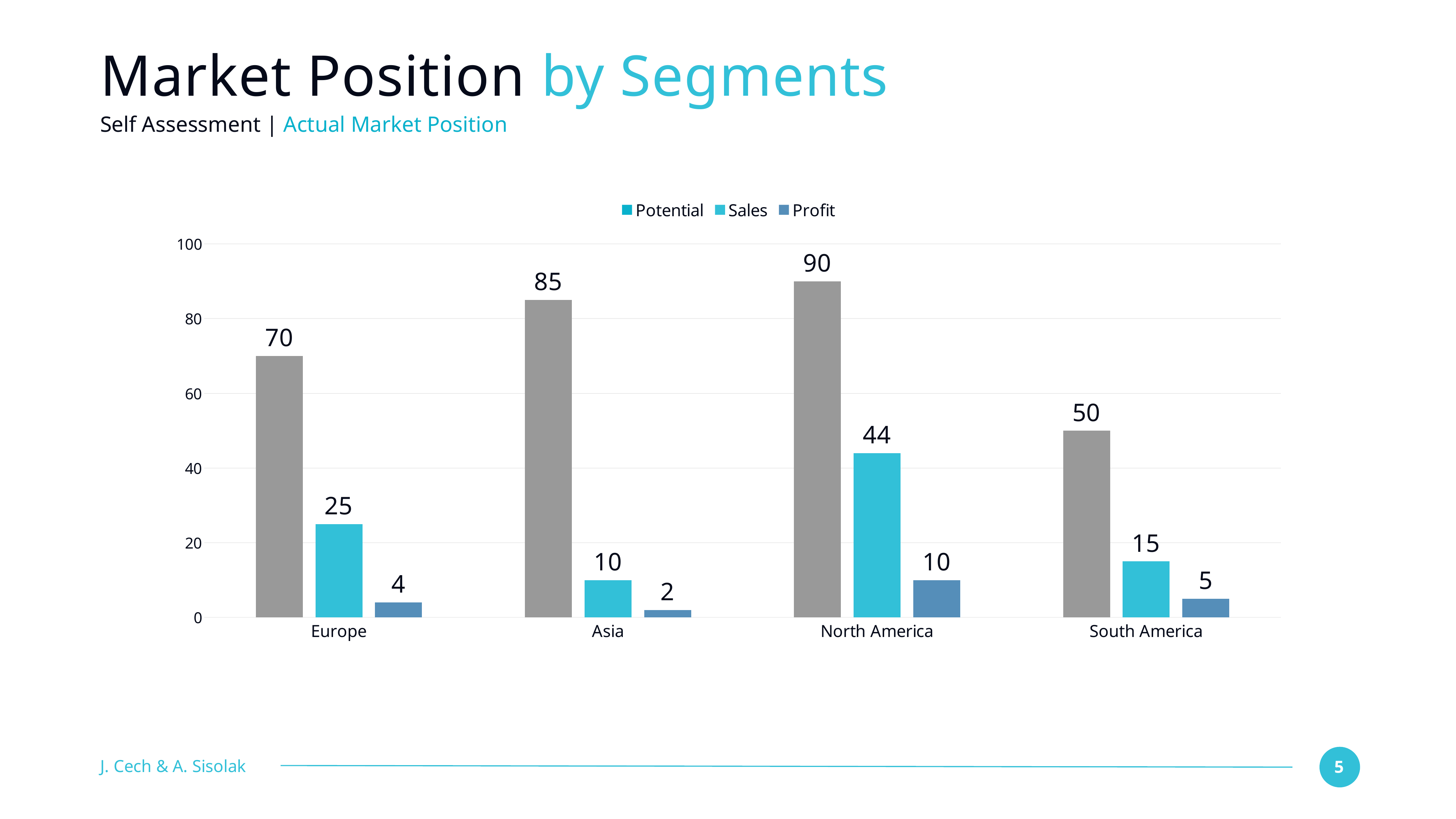
What is the Sales value for North America? 44 What kind of chart is shown on the slide? bar chart What is the Potential value for Asia? 85 How many regions are shown on the x axis? 4 Is the Potential value for South America greater or less than 60? less What is the Profit value for South America? 5 Which region has the lowest Profit value? Asia What is the difference between the Potential and Sales values for Europe? 45 Which is larger, the Sales value for Europe or the Sales value for South America? Europe What is the subtitle text shown below the slide title? Self Assessment | Actual Market Position How many series does the legend list? 3 Which region has the highest Potential value? North America